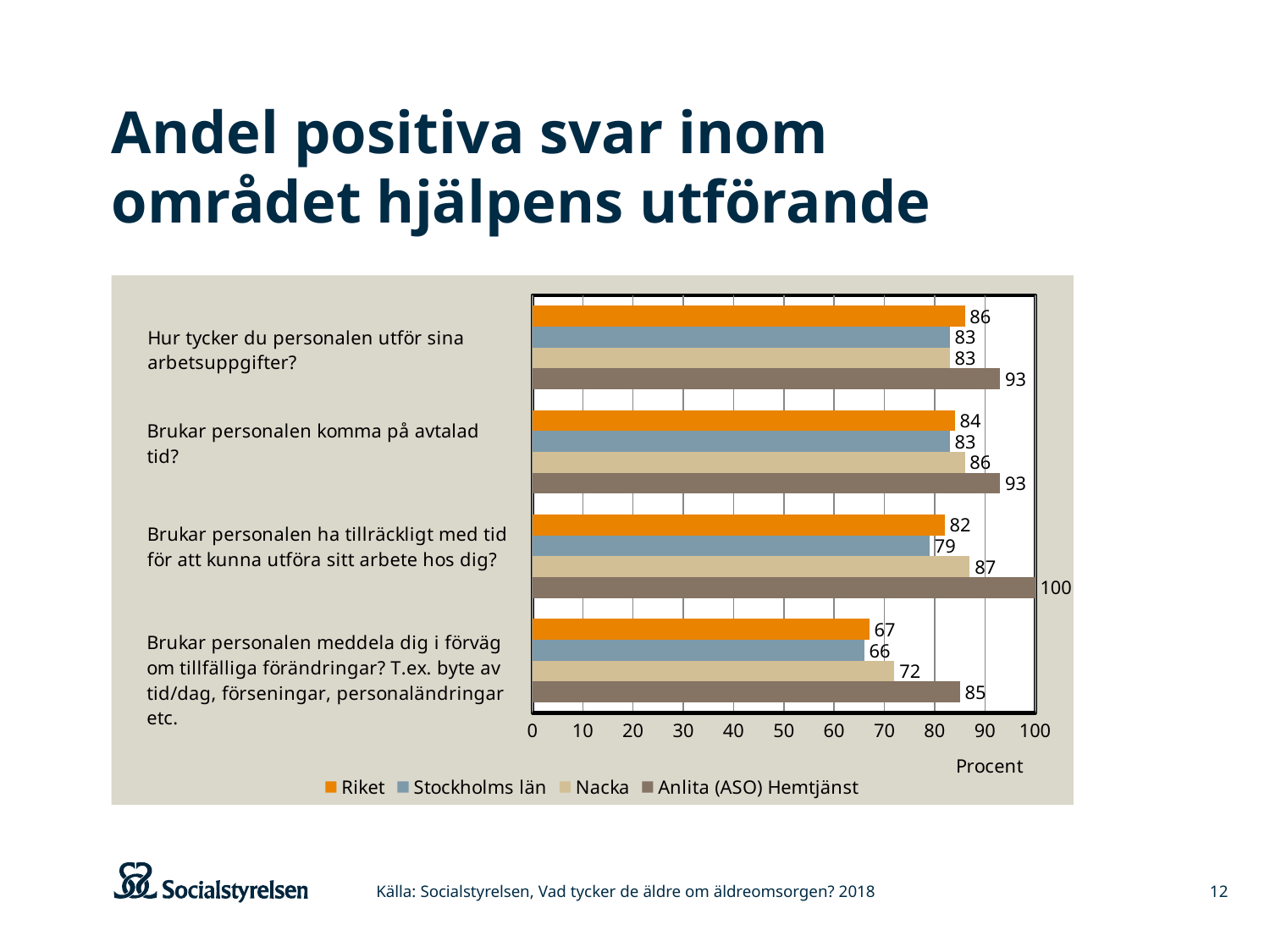
What kind of chart is shown on the slide? Bar chart What is the difference between Nacka and Stockholms län on "Brukar personalen meddela dig i förväg om tillfälliga förändringar?"? 6 Which is larger on "Brukar personalen komma på avtalad tid?": Riket or Nacka? Nacka Which series has the lowest value on "Brukar personalen ha tillräckligt med tid för att kunna utföra sitt arbete hos dig?"? Stockholms län How many series does the legend list? 4 What is the value for Nacka on "Brukar personalen komma på avtalad tid?"? 86 How many question categories are shown on the chart? 4 What is the value for Riket on "Brukar personalen meddela dig i förväg om tillfälliga förändringar?"? 67 Which series has the highest value on "Brukar personalen meddela dig i förväg om tillfälliga förändringar?"? Anlita (ASO) Hemtjänst What is the value for Anlita (ASO) Hemtjänst on "Brukar personalen ha tillräckligt med tid för att kunna utföra sitt arbete hos dig?"? 100 What is the difference between Anlita (ASO) Hemtjänst and Riket on "Hur tycker du personalen utför sina arbetsuppgifter?"? 7 What is the value for Stockholms län on "Hur tycker du personalen utför sina arbetsuppgifter?"? 83